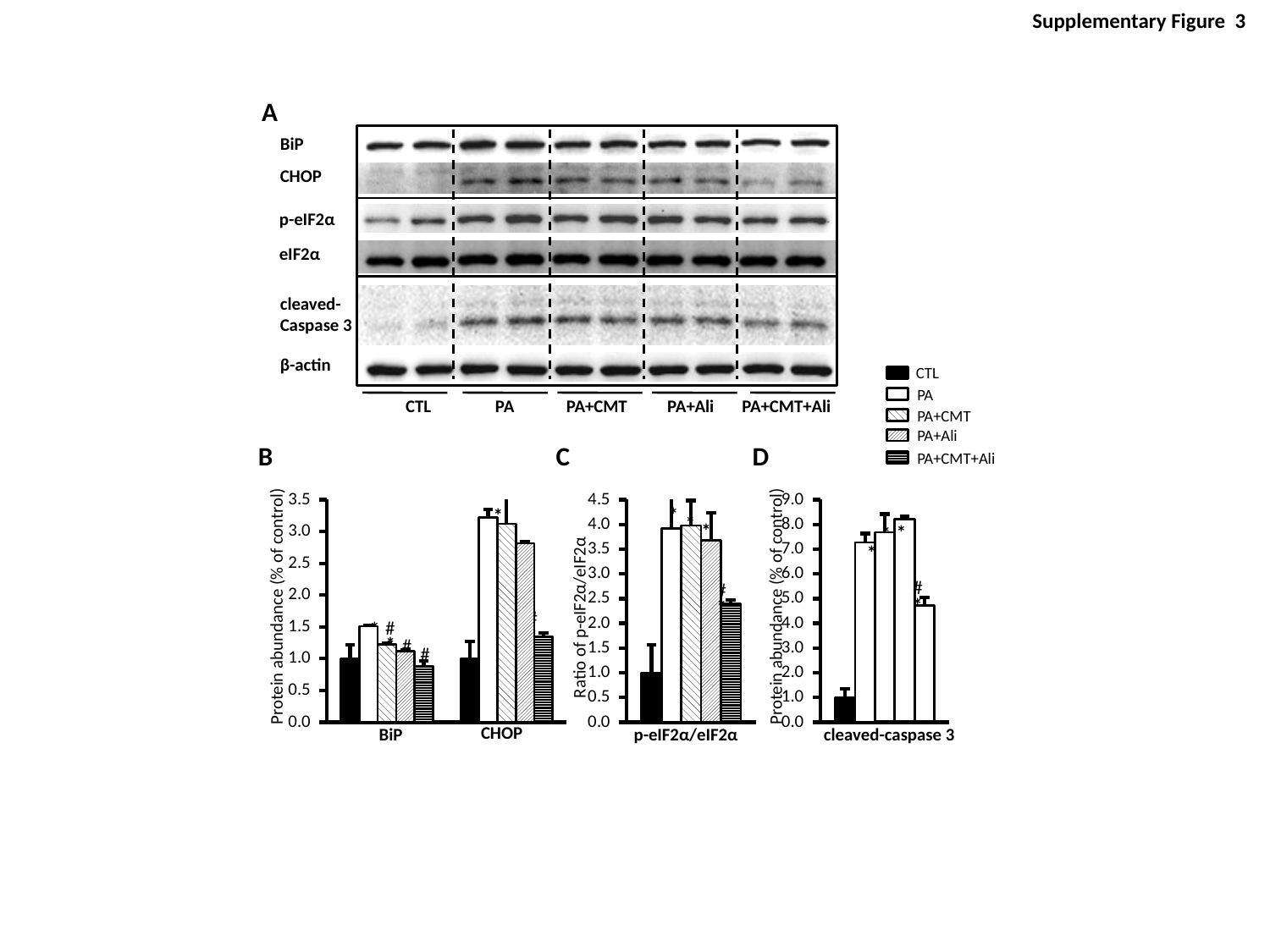
In chart B, how many categories are shown on the x axis? 2 In chart D, is the value for CTL greater or less than 2.0? less In chart C, is the value for PA+CMT+Ali greater or less than 3.0? less In chart B, is the BiP value for PA greater or less than 1.0? greater In chart B, for BiP, which is larger: PA or PA+CMT+Ali? PA In chart B, which series has the lowest value for CHOP? CTL What is the y-axis label of chart D? Protein abundance (% of control) How many series does the legend list for the bar charts? 5 In chart C, which series has the lowest value? CTL What kind of chart is chart B? bar chart